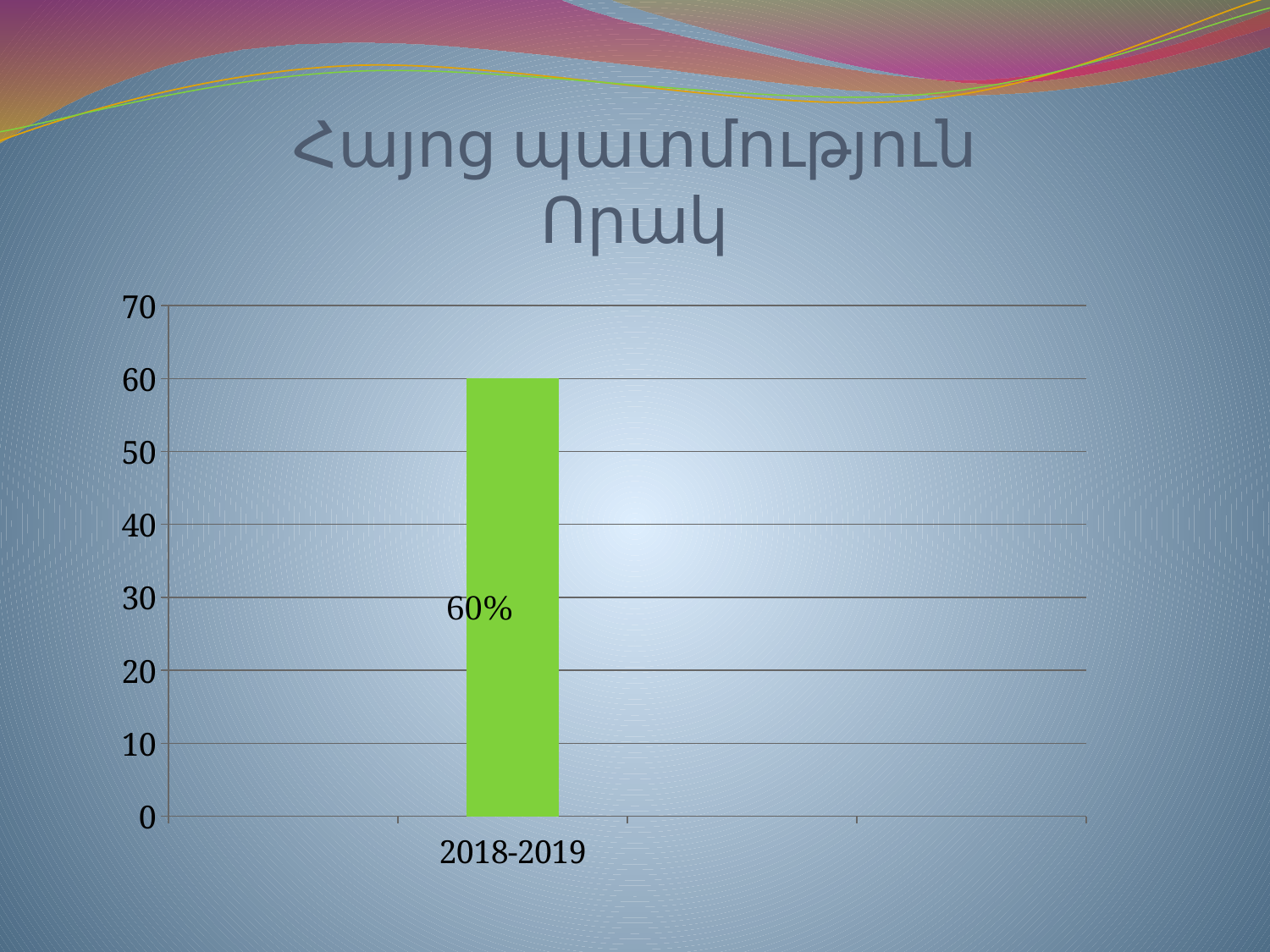
Is the value for 2018-2019 greater or less than 50? greater Which category label appears on the x axis? 2018-2019 What is the highest value shown on the vertical axis? 70 What colour is the bar in the chart? green What is the value shown for 2018-2019? 60% How many categories are plotted on the x axis? 1 What kind of chart is shown on the slide? bar chart Is the value for 2018-2019 greater or less than 70? less